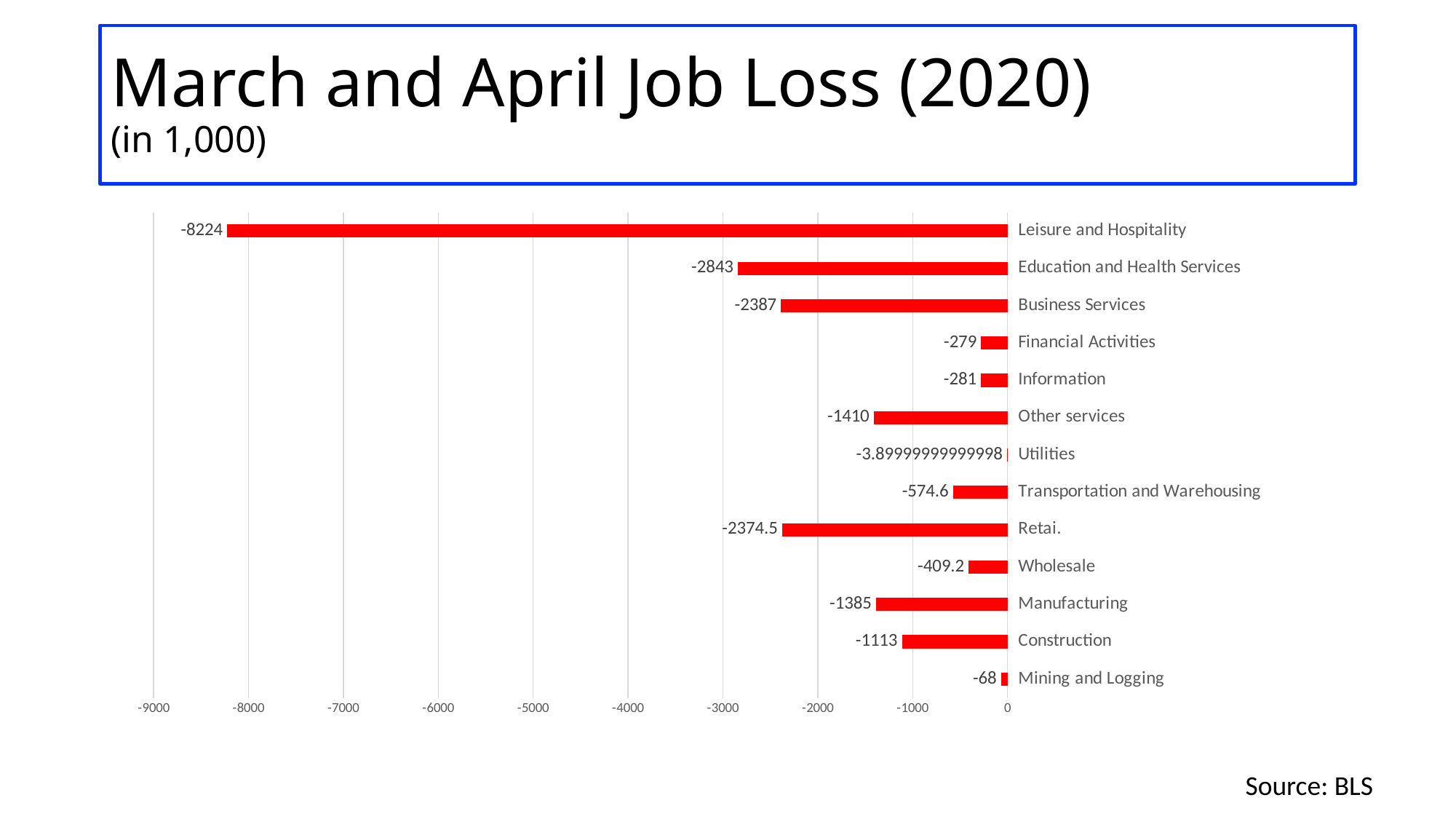
What is the title of the chart on the slide? March and April Job Loss (2020) (in 1,000) How many industry categories are plotted in the chart? 13 Which category shows the smallest job loss (the shortest bar)? Utilities Is the value for Construction greater or less than -1000? less Which category has a larger job loss, Retail or Transportation and Warehousing? Retail Which category shows the largest job loss (the longest bar)? Leisure and Hospitality What is the value shown for Education and Health Services? -2843 What is the value shown for Mining and Logging? -68 What is the difference between the values for Education and Health Services and Business Services? 456 What is the value shown for Leisure and Hospitality? -8224 What is the value shown for Transportation and Warehousing? -574.6 What type of chart is shown on the slide? Bar chart